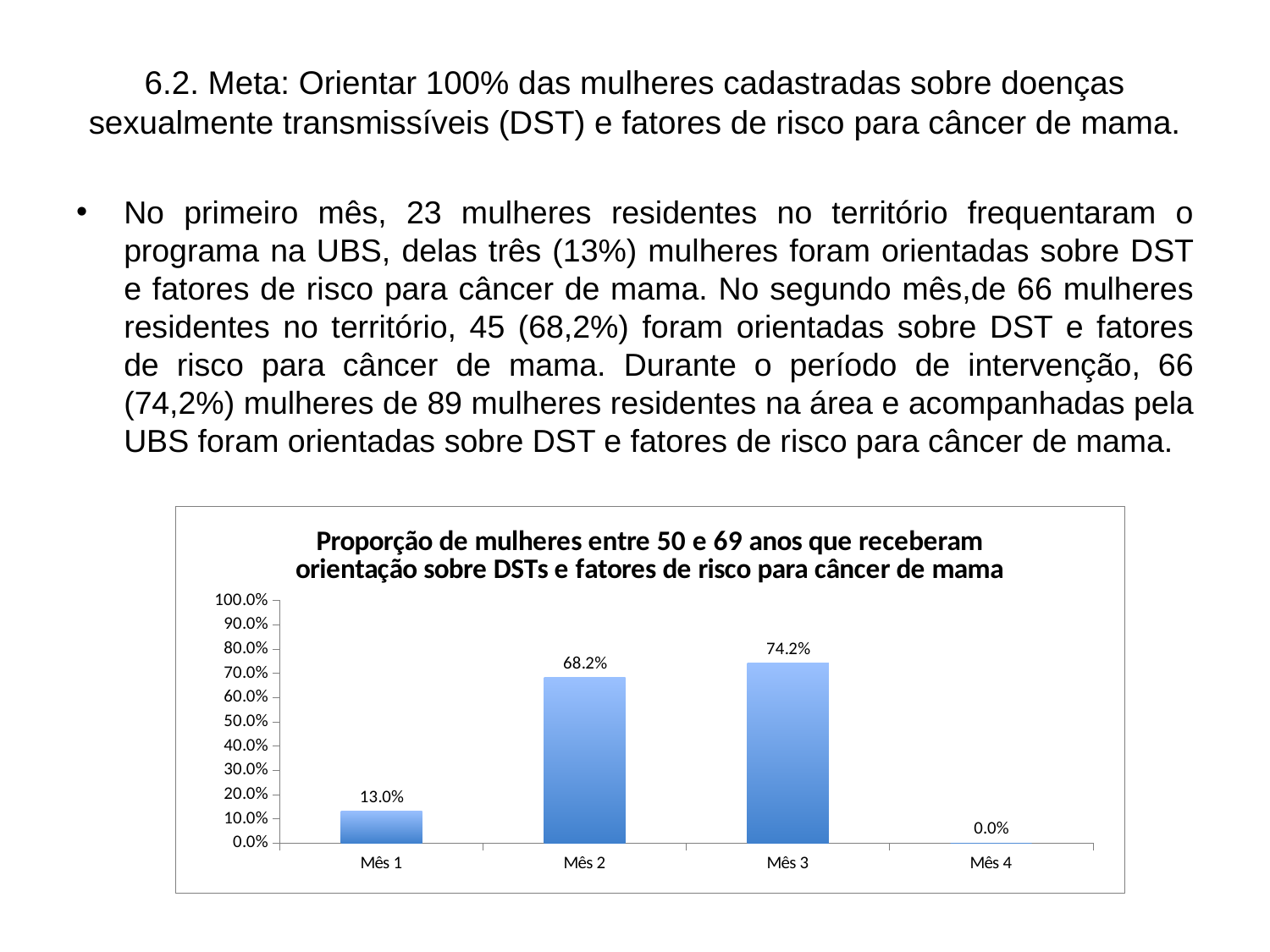
What kind of chart is shown on the slide? Bar chart How many categories are shown on the x axis? 4 What is the value for Mês 1? 13.0% Which month has the lowest value? Mês 4 Which is larger, the value for Mês 1 or the value for Mês 2? Mês 2 What is the title of the chart? Proporção de mulheres entre 50 e 69 anos que receberam orientação sobre DSTs e fatores de risco para câncer de mama What is the difference between the values for Mês 2 and Mês 1? 55.2% Which month has the highest value? Mês 3 What is the value for Mês 2? 68.2% What is the value for Mês 4? 0.0% What is the difference between the values for Mês 3 and Mês 2? 6.0% What is the value for Mês 3? 74.2%